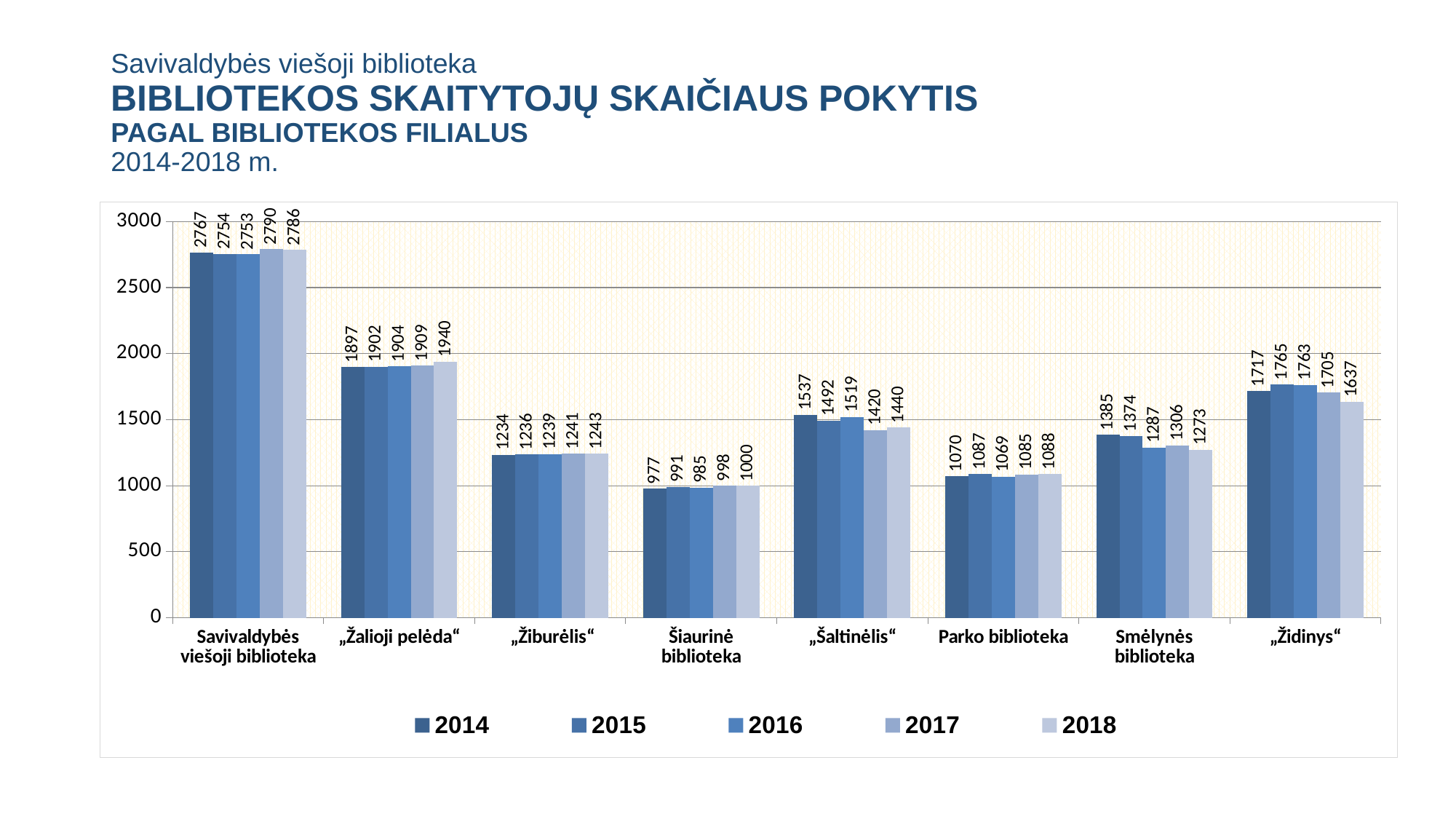
For „Šaltinėlis“, which year has the larger value, 2014 or 2017? 2014 Do the values for „Žiburėlis“ rise or fall from 2014 to 2018? rise What kind of chart is shown on the slide? bar chart How many series does the legend list? 5 What is the value for Smėlynės biblioteka in 2016? 1287 What is the value for „Šaltinėlis“ in 2014? 1537 Is the value for Parko biblioteka in 2018 greater or less than 1000? greater What is the value for „Žalioji pelėda“ in 2018? 1940 Which library has the highest value in 2018? Savivaldybės viešoji biblioteka What is the difference between the 2014 and 2018 values for Smėlynės biblioteka? 112 Which library has the lowest value in 2014? Šiaurinė biblioteka How many libraries (categories) are shown on the x axis? 8